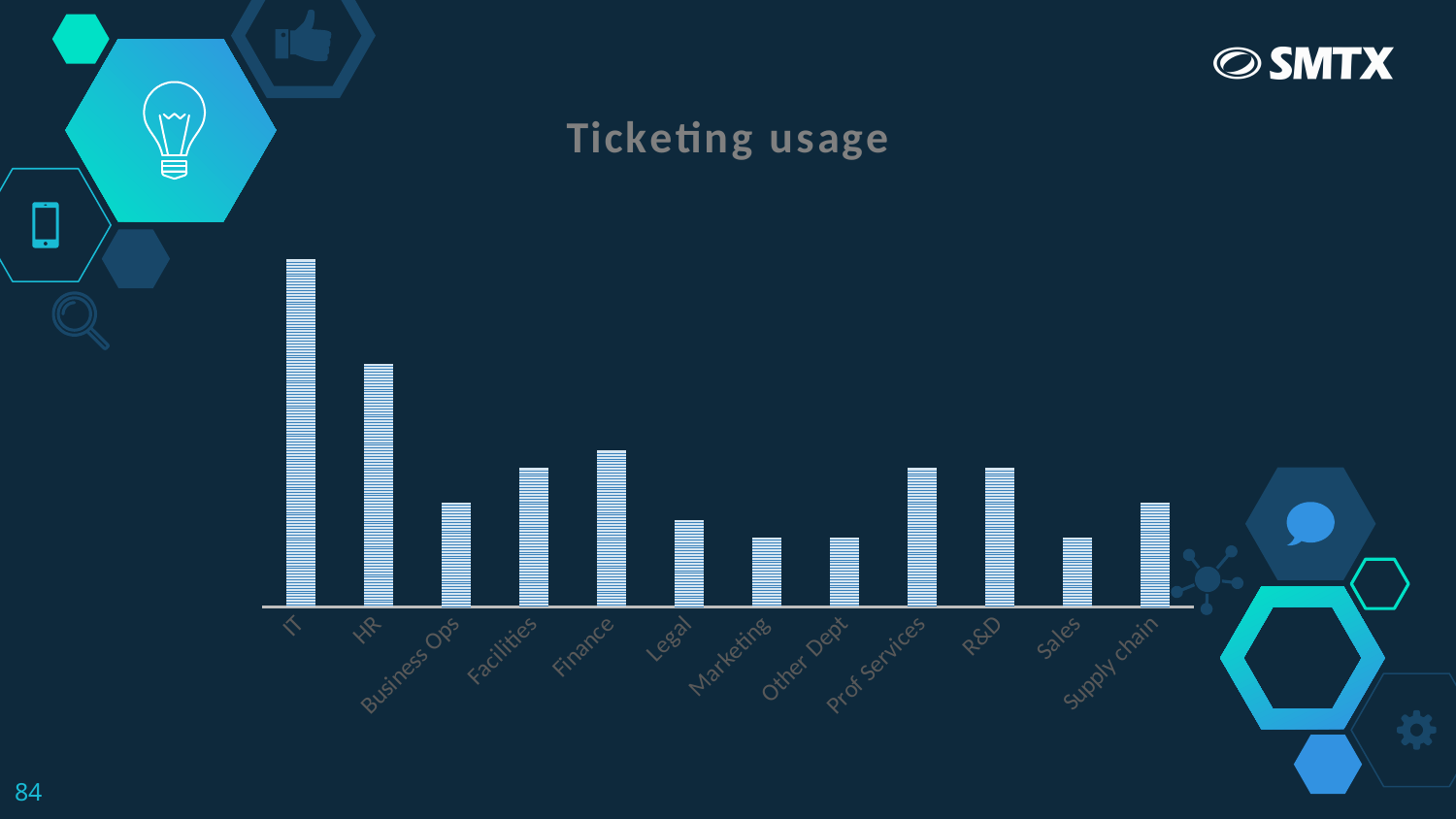
Across the first three categories (IT, HR, Business Ops), do the values rise or fall? fall How many categories are shown on the x axis of the chart? 12 Which is larger, the value for Prof Services or the value for Marketing? Prof Services Which is larger, the value for Business Ops or the value for HR? HR Which is larger, the value for Finance or the value for Legal? Finance Which category has the highest value in the chart? IT What is the first category on the x axis of the chart? IT What is the title of the chart? Ticketing usage What kind of chart is shown on the slide? bar chart